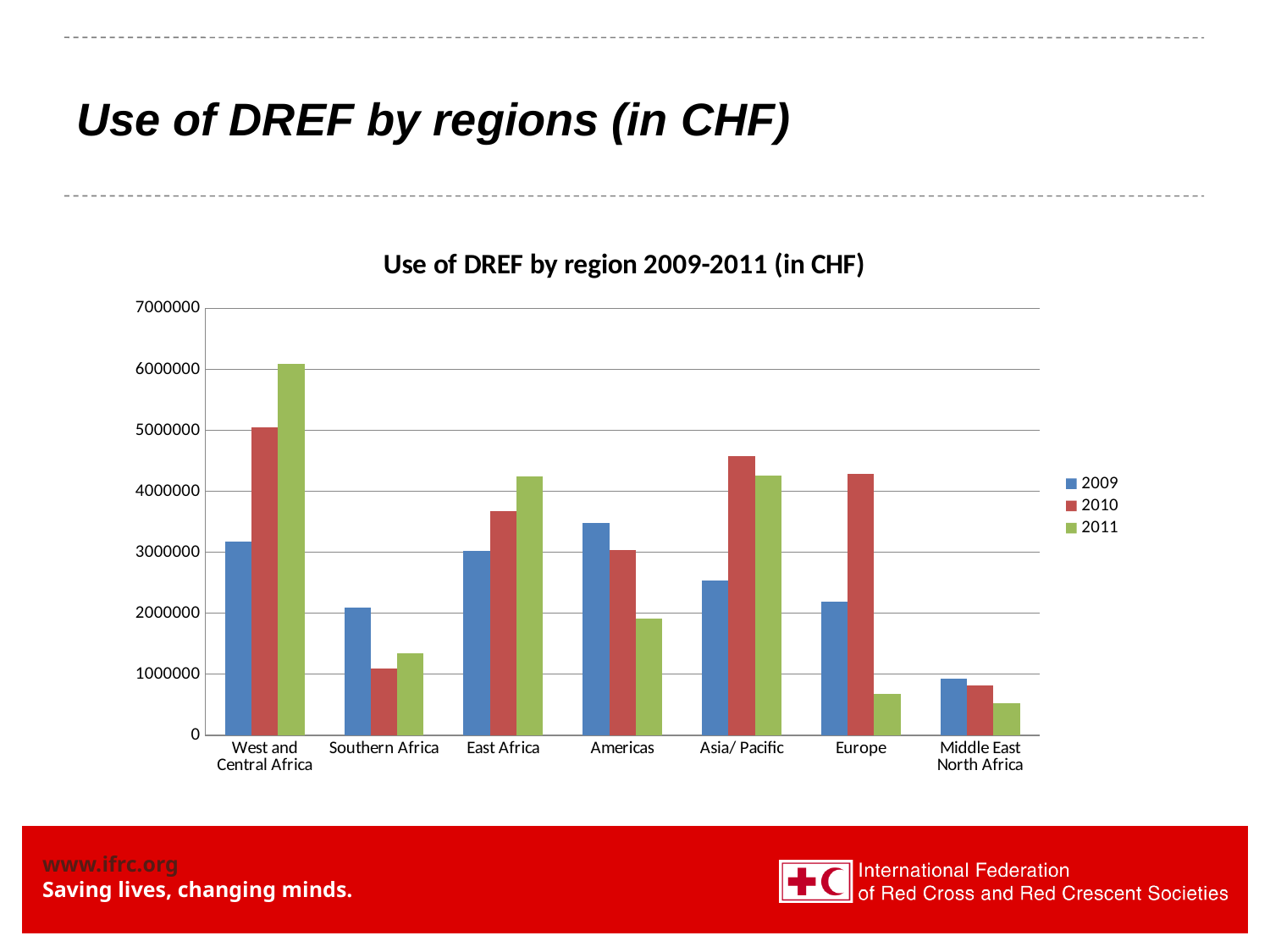
Which region has the highest value for 2011? West and Central Africa Is the value for West and Central Africa in 2011 greater or less than 5000000? greater How many series does the legend list? 3 How many regions are shown on the x axis? 7 Do the values for Americas rise or fall from 2009 to 2011? fall Do the values for West and Central Africa rise or fall from 2009 to 2011? rise What kind of chart is shown on the slide? bar chart Which region has the lowest value for 2010? Middle East North Africa For Asia/ Pacific, which year has the larger value, 2009 or 2010? 2010 Is the value for Europe in 2011 greater or less than 1000000? less Is the value for Americas in 2009 greater or less than 3000000? greater What colour represents the 2010 series in the legend? red